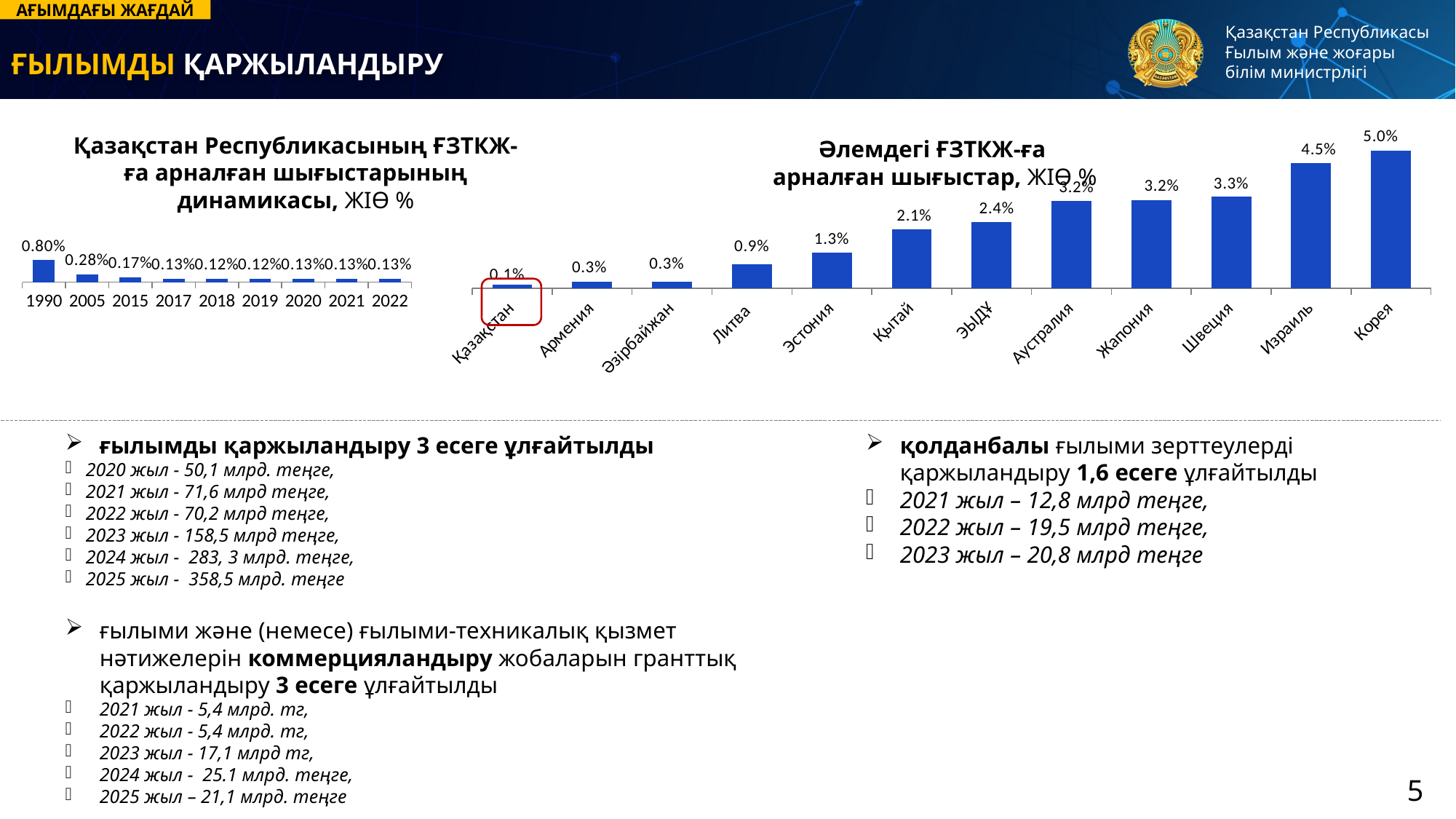
What type of chart is the right chart? bar chart In the right chart, which is larger, the value for Израиль or the value for Швеция? Израиль In the right chart, which country has the lowest value? Қазақстан In the left chart, how many years are shown on the x axis? 9 In the right chart (Әлемдегі ҒЗТКЖ-ға арналған шығыстар), what is the value for Корея? 5.0% In the left chart, which year has the highest value? 1990 In the left chart, what is the value for 2005? 0.28% In the left chart, what is the difference between the values for 1990 and 2022? 0.67% In the right chart, what is the value for Қытай? 2.1% In the left chart, do the values generally rise or fall from 1990 to 2022? fall In the right chart, what is the difference between the values for Корея and Қазақстан? 4.9% In the left chart (Қазақстан Республикасының ҒЗТКЖ-ға арналған шығыстарының динамикасы), what is the value for 1990? 0.80%